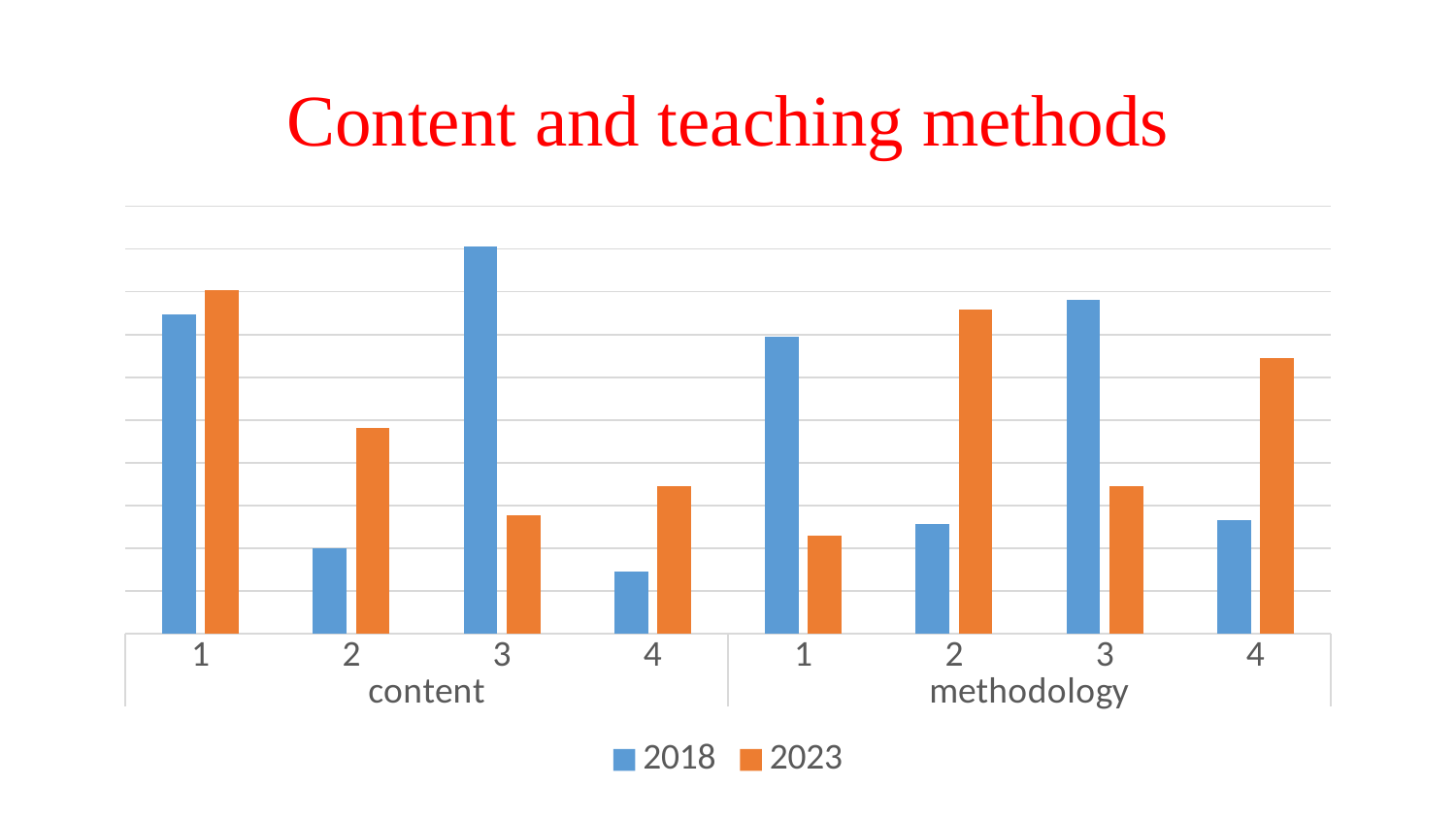
Which category has the lowest value for the 2018 series? content 4 What kind of chart is shown on the slide? bar chart Which category has the highest value for the 2023 series? content 1 How many categories are plotted along the x axis in total? 8 Which category has the highest value for the 2018 series? content 3 How many series does the legend list? 2 Which series is shown in orange? 2023 For content 3, which series has the larger value, 2018 or 2023? 2018 What is the title of the slide? Content and teaching methods For methodology 2, which series has the larger value, 2018 or 2023? 2023 For methodology 3, which series has the larger value, 2018 or 2023? 2018